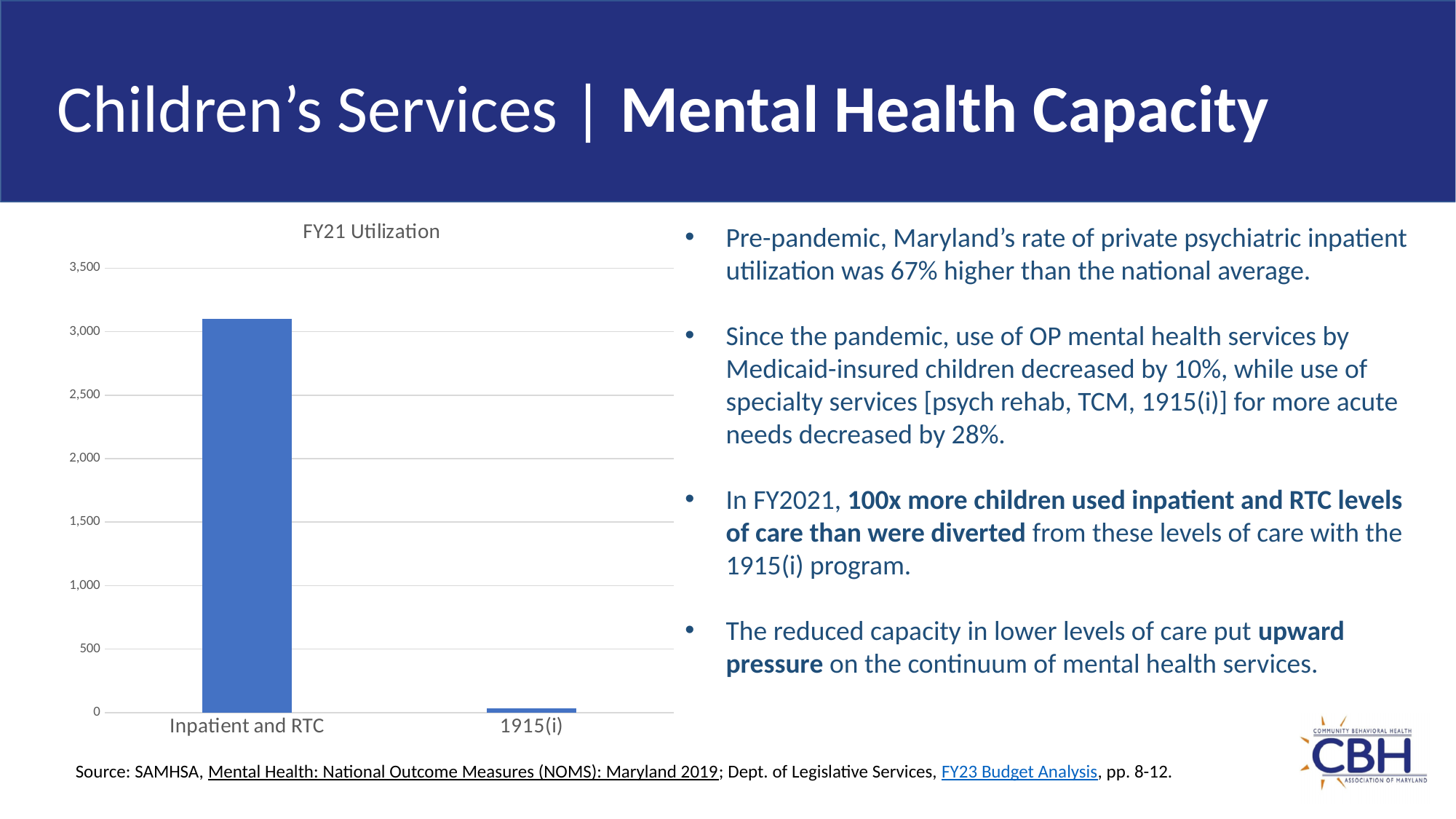
Is the value for 1915(i) greater or less than 500? less Is the value for Inpatient and RTC greater or less than 2,500? greater Which category has the highest value in the chart? Inpatient and RTC Which category has the lowest value in the chart? 1915(i) Do the values rise or fall moving from left to right along the x axis? fall Is the value for Inpatient and RTC greater or less than 3,500? less What is the title of the chart? FY21 Utilization Which is larger, the value for Inpatient and RTC or the value for 1915(i)? Inpatient and RTC What is the highest value shown on the vertical axis of the chart? 3,500 How many categories are shown on the x axis of the chart? 2 What kind of chart is shown on the slide? bar chart